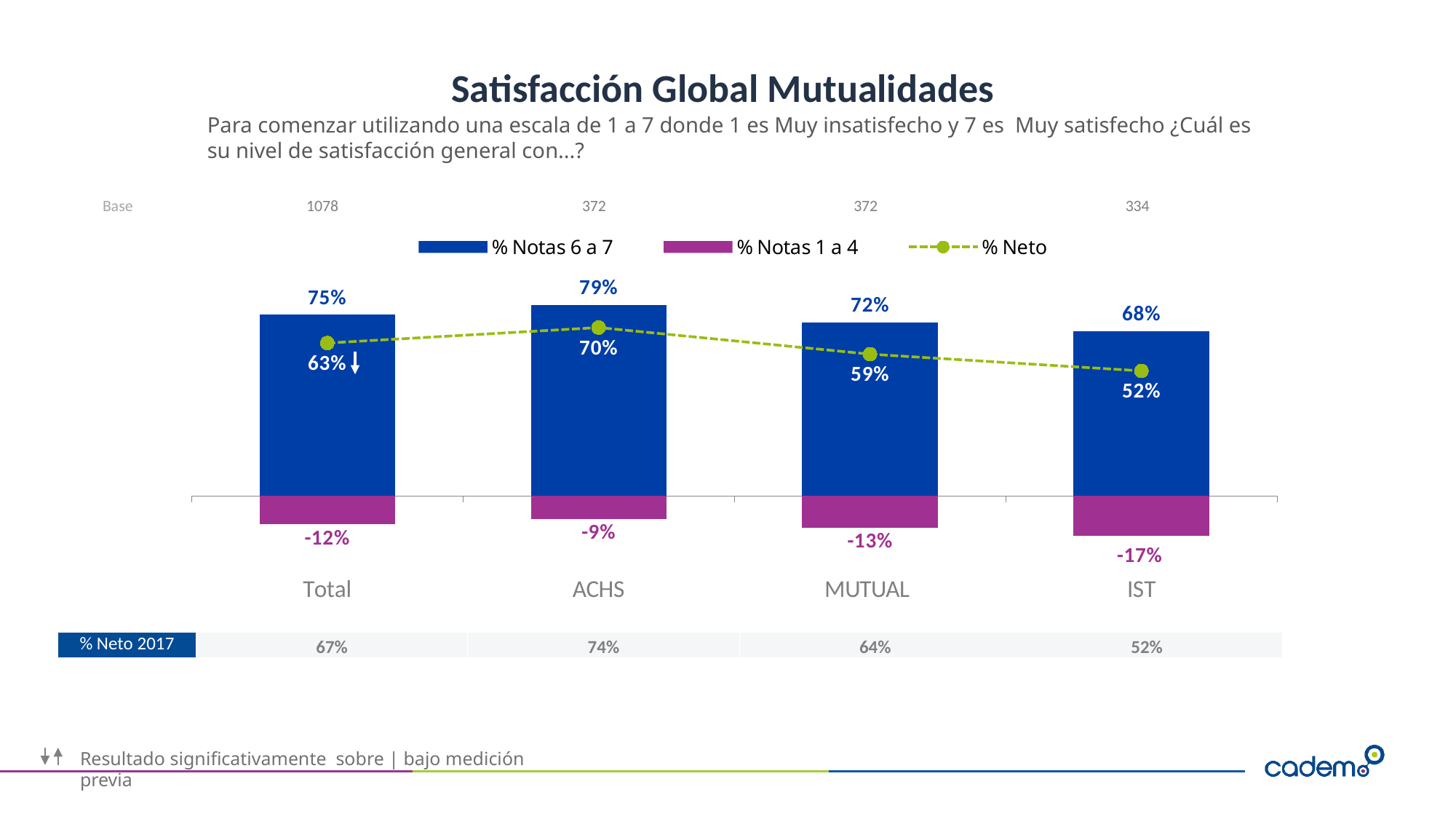
Which category has the highest % Notas 6 a 7 value? ACHS What is the title of the chart? Satisfacción Global Mutualidades Which is larger, the % Neto value for Total or for ACHS? ACHS What kind of chart is shown on the slide? Combined bar and line chart What is the difference between the % Notas 6 a 7 values for ACHS and IST? 11% How many series does the legend list? 3 What is the % Notas 1 a 4 value for IST? -17% Do the % Neto values rise or fall from ACHS to IST along the x axis? Fall Which category has the lowest % Neto value? IST What is the % Neto value for MUTUAL? 59% How many categories are shown on the x axis? 4 What is the % Notas 6 a 7 value for ACHS? 79%